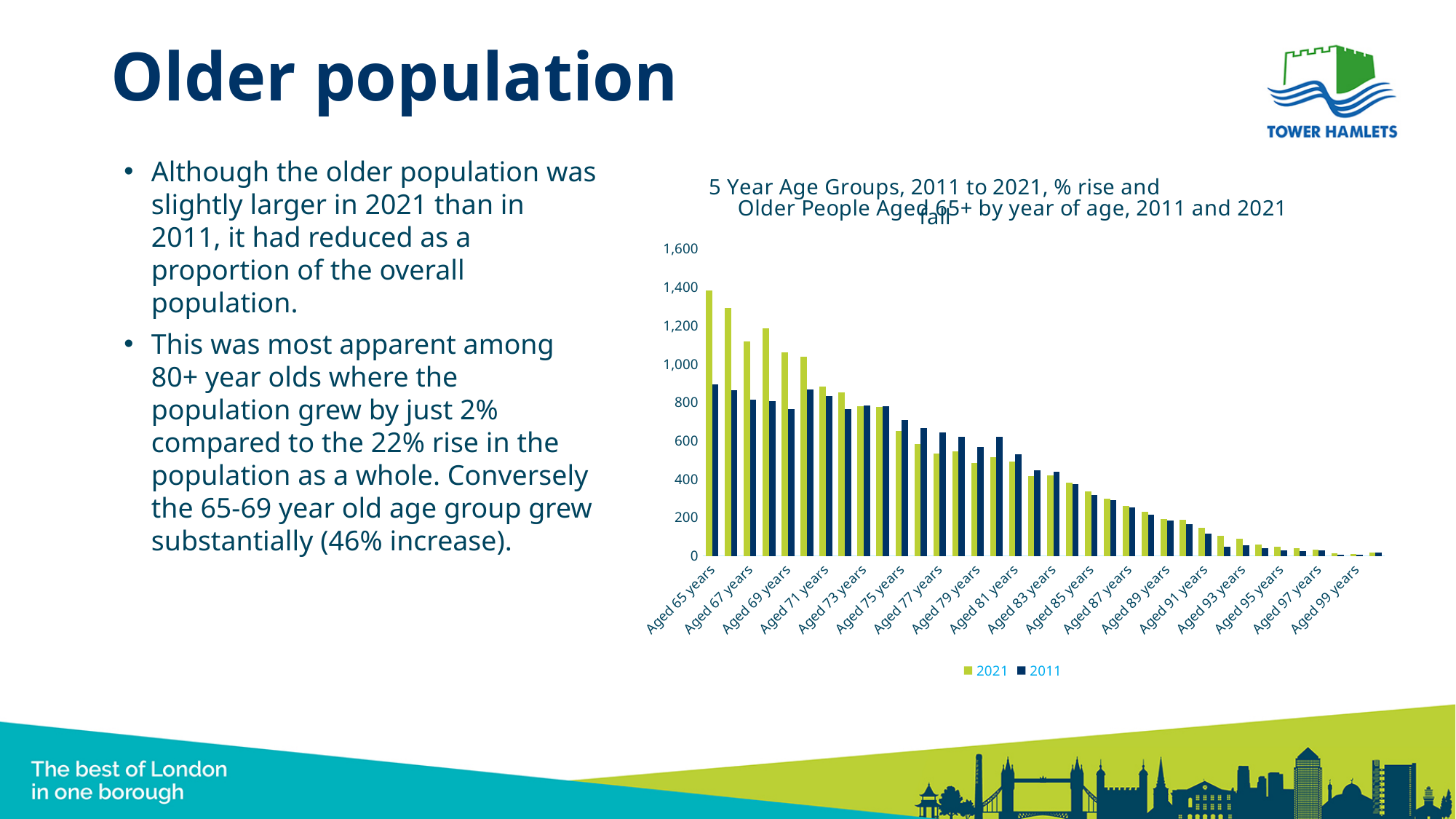
Is the 2011 value for Aged 65 years greater or less than 1,000? less For Aged 77 years, which series has the larger value, 2021 or 2011? 2011 Is the 2011 value for Aged 85 years greater or less than 600? less Which colour represents the 2021 series in the chart? Green For Aged 65 years, which series has the larger value, 2021 or 2011? 2021 What kind of chart is shown on the slide? Bar chart What are the two series named in the chart's legend? 2021 and 2011 Do the values generally rise or fall as age increases along the x axis? Fall Is the 2021 value for Aged 99 years greater or less than 200? less How many series does the chart's legend list? 2 Which age has the highest 2021 value in the chart? Aged 65 years